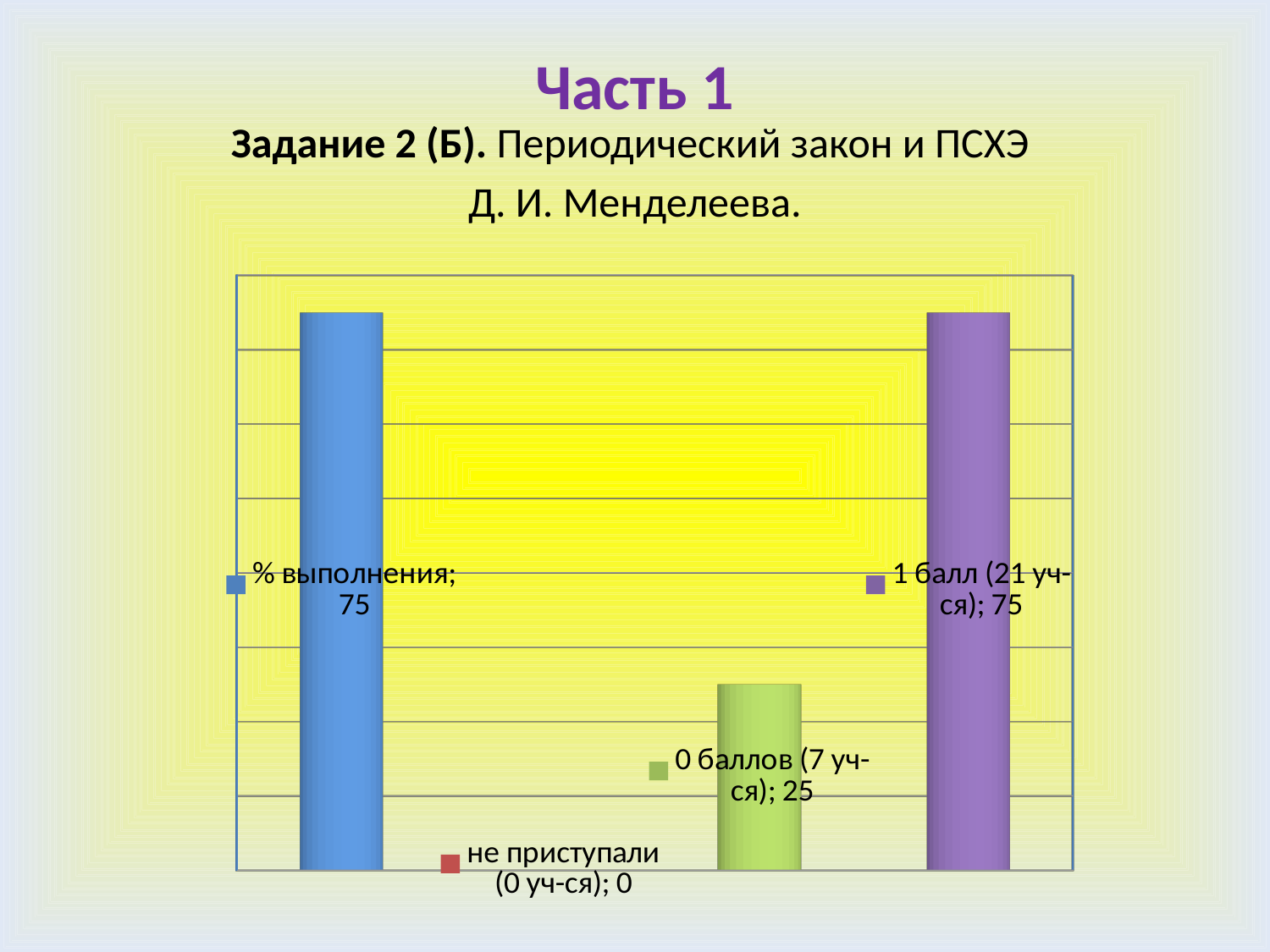
Which is larger, the value for "не приступали (0 уч-ся)" or the value for "0 баллов (7 уч-ся)"? 0 баллов (7 уч-ся) What is the value for "не приступали (0 уч-ся)"? 0 Which is larger, the value for "0 баллов (7 уч-ся)" or the value for "1 балл (21 уч-ся)"? 1 балл (21 уч-ся) What colour is the bar for "1 балл (21 уч-ся)"? purple What is the difference between the values for "1 балл (21 уч-ся)" and "0 баллов (7 уч-ся)"? 50 What is the difference between the values for "% выполнения" and "0 баллов (7 уч-ся)"? 50 What is the value for "% выполнения"? 75 What is the value for "1 балл (21 уч-ся)"? 75 What is the value for "0 баллов (7 уч-ся)"? 25 What kind of chart is shown on the slide? bar chart Which category has the lowest value? не приступали (0 уч-ся) How many bars are plotted in the chart? 3